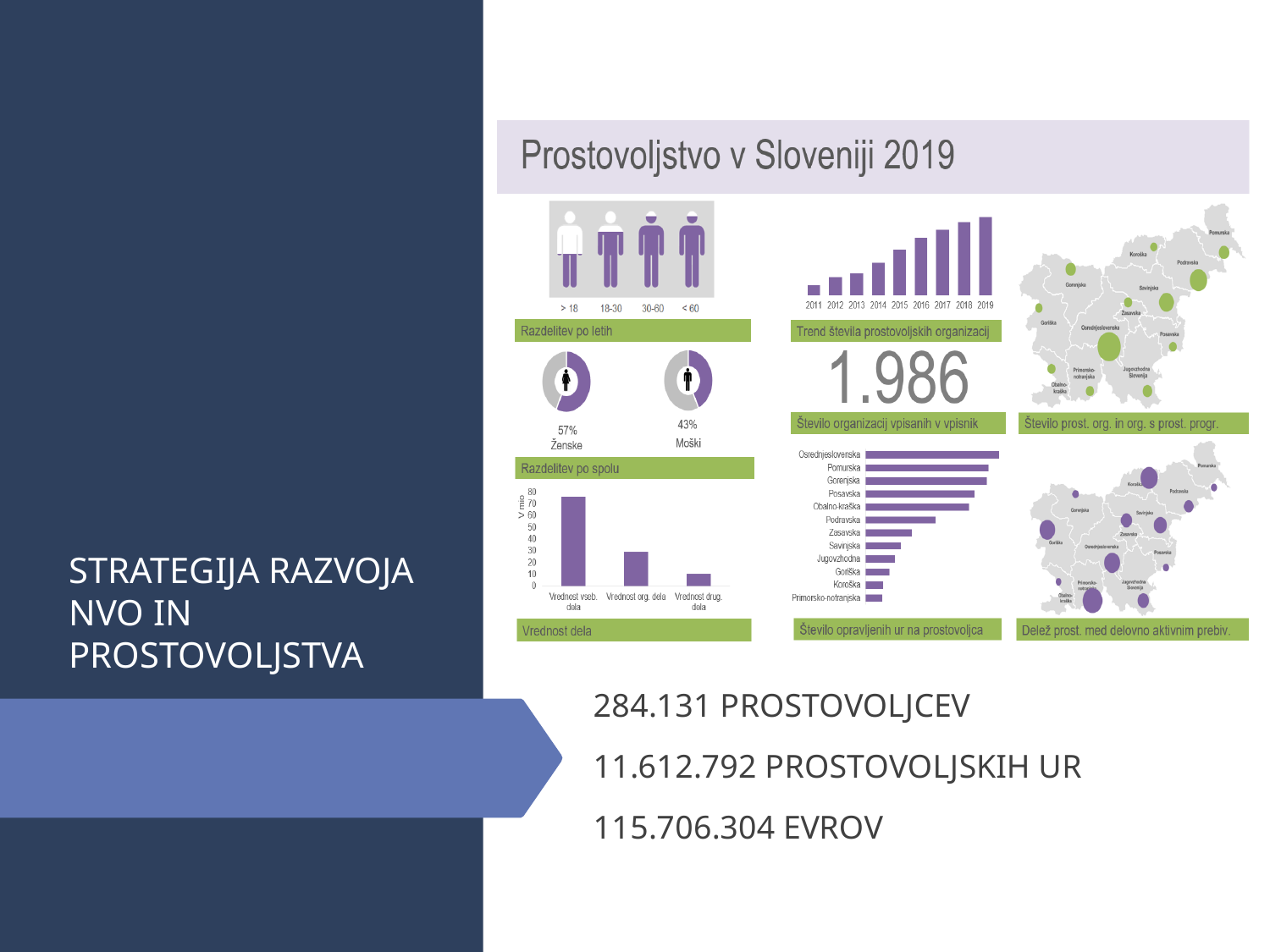
In the 'Razdelitev po spolu' chart, what percentage is shown for Ženske? 57% In the 'Razdelitev po spolu' chart, what percentage is shown for Moški? 43% In the 'Vrednost dela' chart, is the value for Vrednost vseb. dela greater or less than 60? greater In the 'Vrednost dela' chart, which category has the highest bar? Vrednost vseb. dela In the 'Vrednost dela' chart, how many categories are shown on the x axis? 3 In the 'Vrednost dela' chart, is the value for Vrednost org. dela greater or less than 40? less In the 'Število opravljenih ur na prostovoljca' chart, which region has the longest bar? Osrednjeslovenska In the 'Razdelitev po spolu' chart, what is the difference between the Ženske and Moški percentages? 14% In the 'Vrednost dela' chart, which category has the lowest bar? Vrednost drug. dela In the 'Trend števila prostovoljskih organizacij' chart, do the values rise or fall from 2011 to 2019? rise In the 'Trend števila prostovoljskih organizacij' chart, how many years are shown? 9